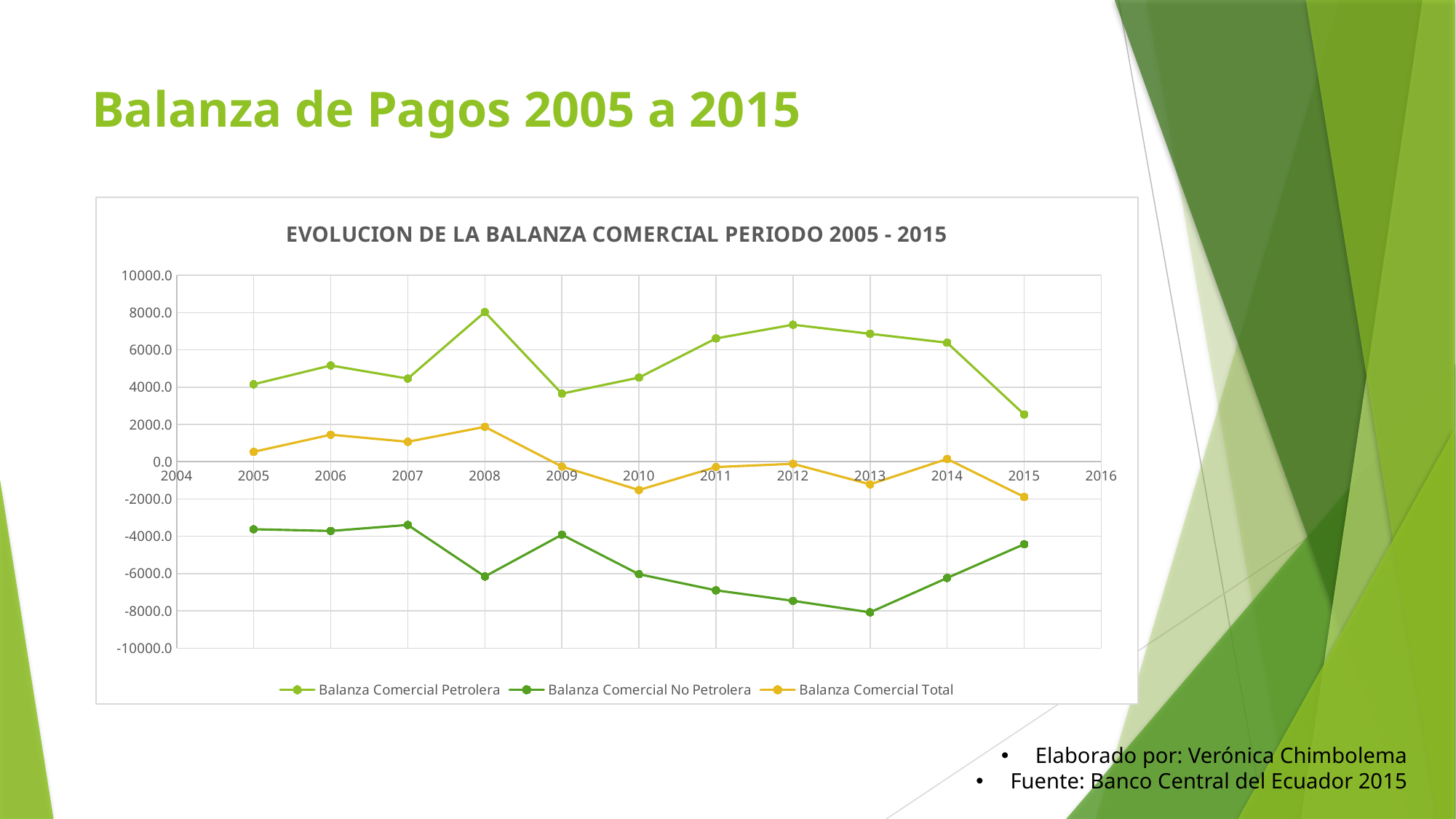
In which year does Balanza Comercial No Petrolera reach its lowest value? 2013 How many years are plotted for each series? 11 What is the title of the chart? EVOLUCION DE LA BALANZA COMERCIAL PERIODO 2005 - 2015 Is the value for Balanza Comercial Total in 2010 greater or less than 0? less What kind of chart is shown on the slide? Line chart In which year does Balanza Comercial Total reach its highest value? 2008 How many series does the legend list? 3 Which is larger, Balanza Comercial Petrolera in 2008 or in 2009? 2008 Does Balanza Comercial Petrolera rise or fall from 2012 to 2015? Fall Is the value for Balanza Comercial Petrolera in 2008 greater or less than 6000? greater Is the value for Balanza Comercial No Petrolera in 2013 greater or less than -6000? less In which year does Balanza Comercial Petrolera reach its highest value? 2008